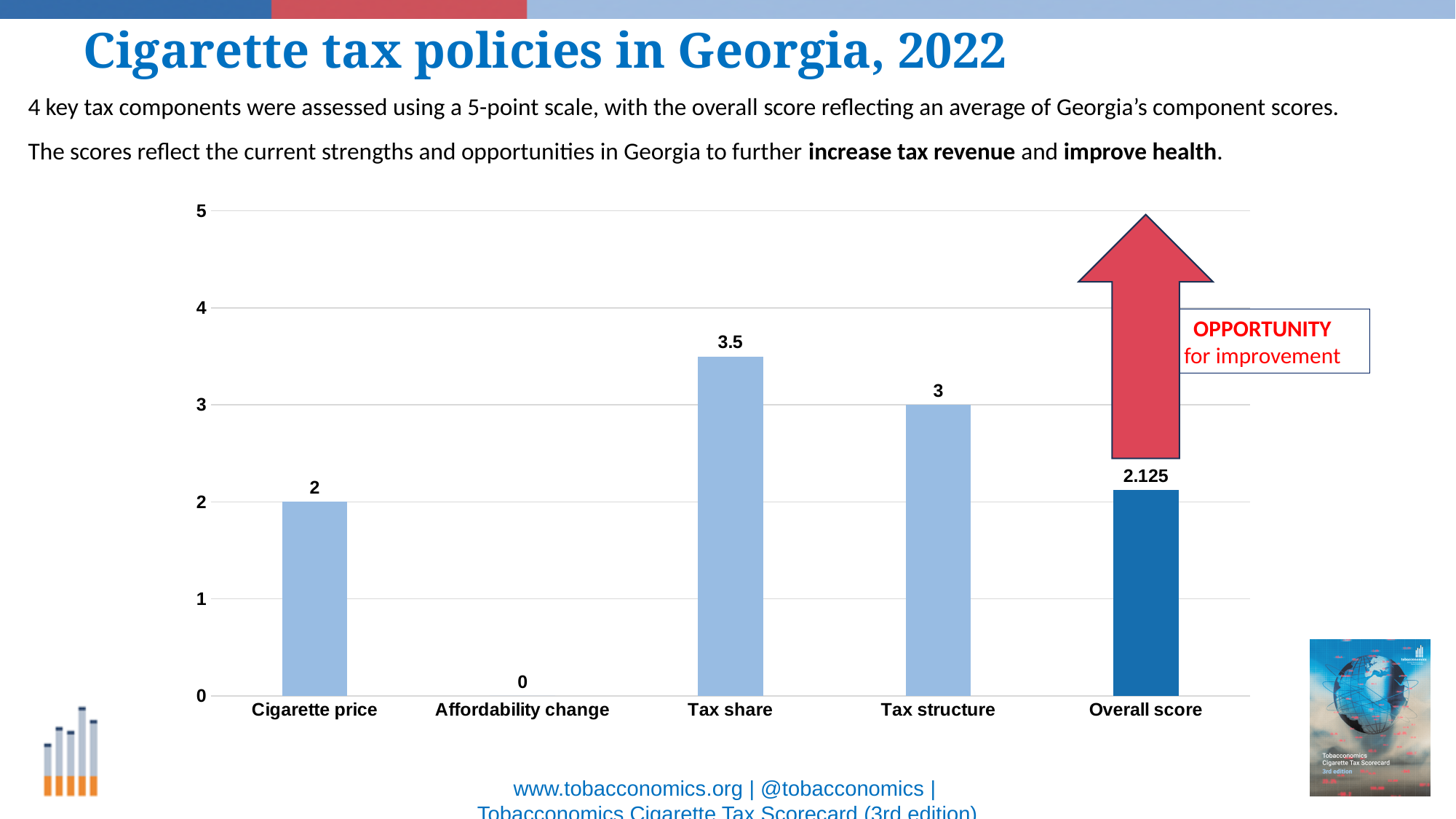
What is the value for Tax structure? 3 Which category has the lowest value? Affordability change What is the value for Tax share? 3.5 What is the value for Affordability change? 0 Is the value for Tax share greater or less than 4? less How many categories are shown on the x axis? 5 What is the value for Cigarette price? 2 What is the Overall score? 2.125 What is the difference between the values for Tax share and Tax structure? 0.5 Which is larger, the value for Cigarette price or the value for Tax structure? Tax structure Which category has the highest value? Tax share What kind of chart is shown on the slide? bar chart